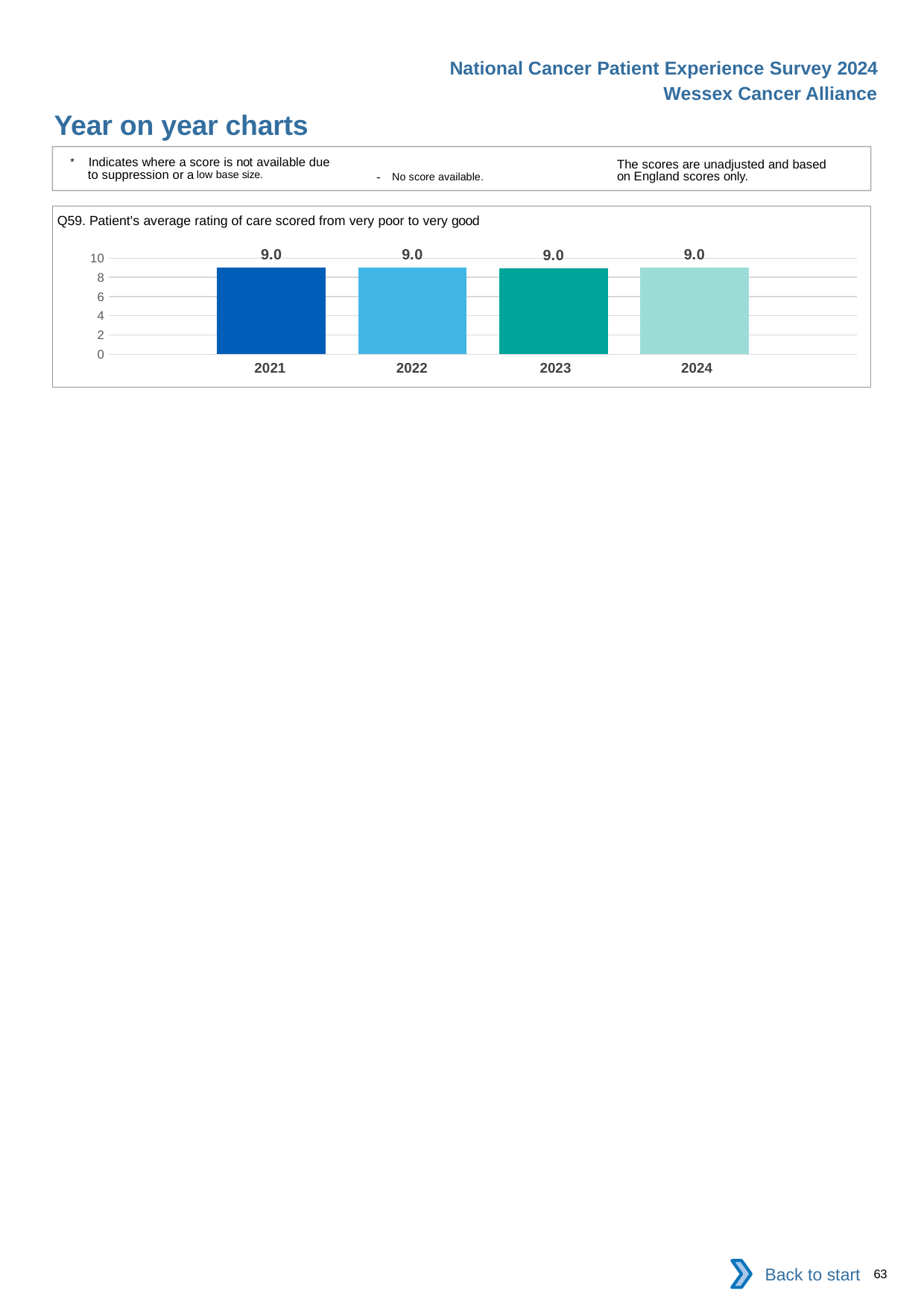
What is the value for 2024 in the Q59 chart? 9.0 What kind of chart is used for Q59? Bar chart Is the value for 2023 in the Q59 chart greater or less than 8? greater How many years are shown in the Q59 chart? 4 What is the highest value shown on the vertical axis of the Q59 chart? 10 What is the title of the chart on the slide? Q59. Patient's average rating of care scored from very poor to very good What is the difference between the 2024 and 2021 values in the Q59 chart? 0.0 Is the value for 2021 in the Q59 chart greater or less than 10? less What is the value for 2023 in the Q59 chart? 9.0 What is the value for 2022 in the Q59 chart? 9.0 What is the value for 2021 in the Q59 chart? 9.0 Do the values in the Q59 chart rise, fall or stay the same from 2021 to 2024? Stay the same